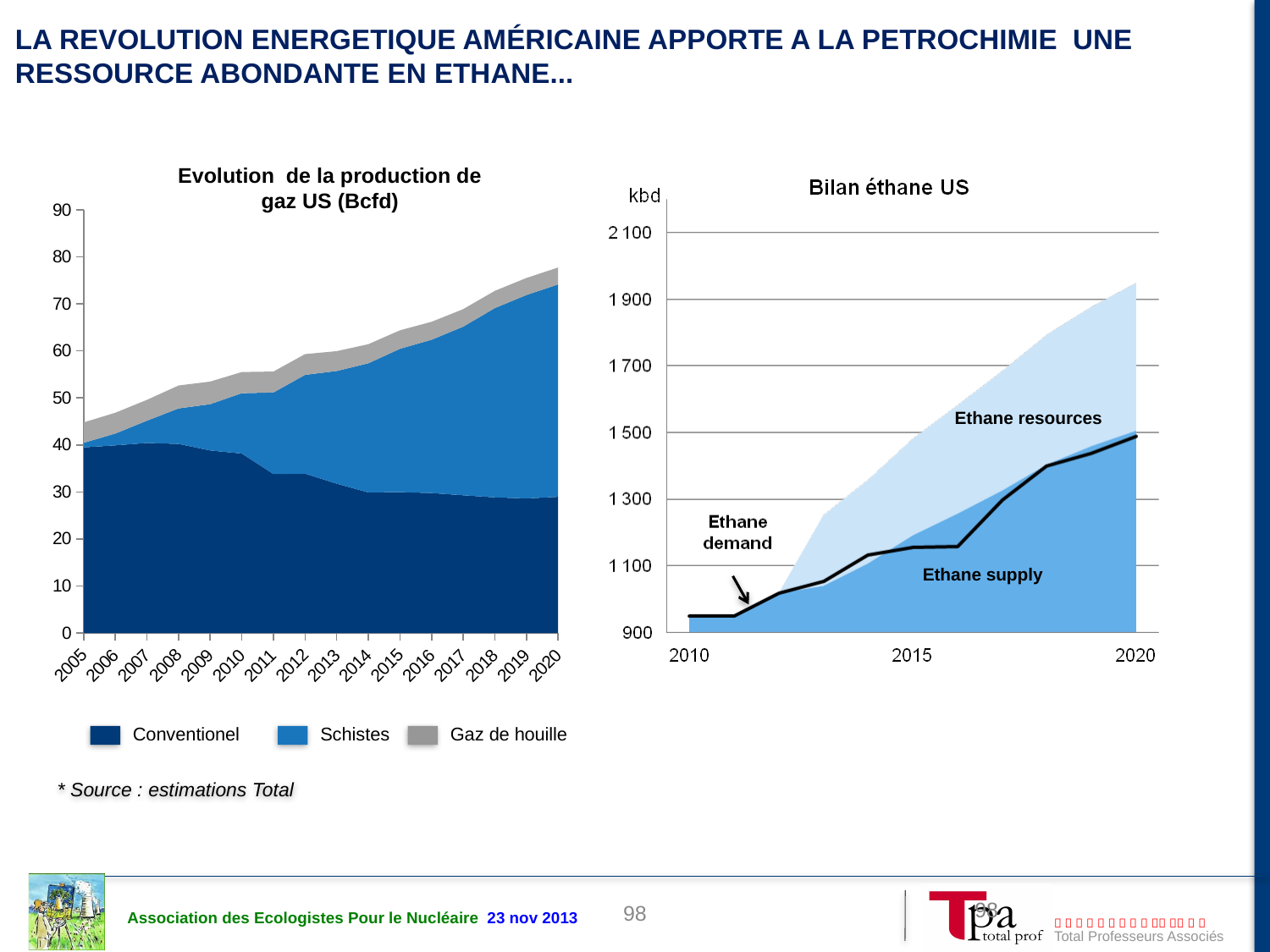
In the right chart "Bilan éthane US", which is larger in 2020, Ethane resources or Ethane supply? Ethane resources In the left chart "Evolution de la production de gaz US (Bcfd)", does the Conventionel series rise or fall from 2005 to 2020? Fall In the left chart "Evolution de la production de gaz US (Bcfd)", is the total production in 2005 greater or less than 50? less In the left chart "Evolution de la production de gaz US (Bcfd)", is the total production in 2020 greater or less than 70? greater What kind of chart is the left chart titled "Evolution de la production de gaz US (Bcfd)"? Stacked area chart In the right chart "Bilan éthane US", is the value of Ethane resources in 2020 greater or less than 1 900? greater In the right chart "Bilan éthane US", what unit is shown on the y axis? kbd In the left chart "Evolution de la production de gaz US (Bcfd)", does the total gas production rise or fall from 2005 to 2020? Rise In the left chart "Evolution de la production de gaz US (Bcfd)", which series is shown in grey? Gaz de houille In the left chart "Evolution de la production de gaz US (Bcfd)", how many series does the legend list? 3 In the left chart "Evolution de la production de gaz US (Bcfd)", how many years are shown on the x axis? 16